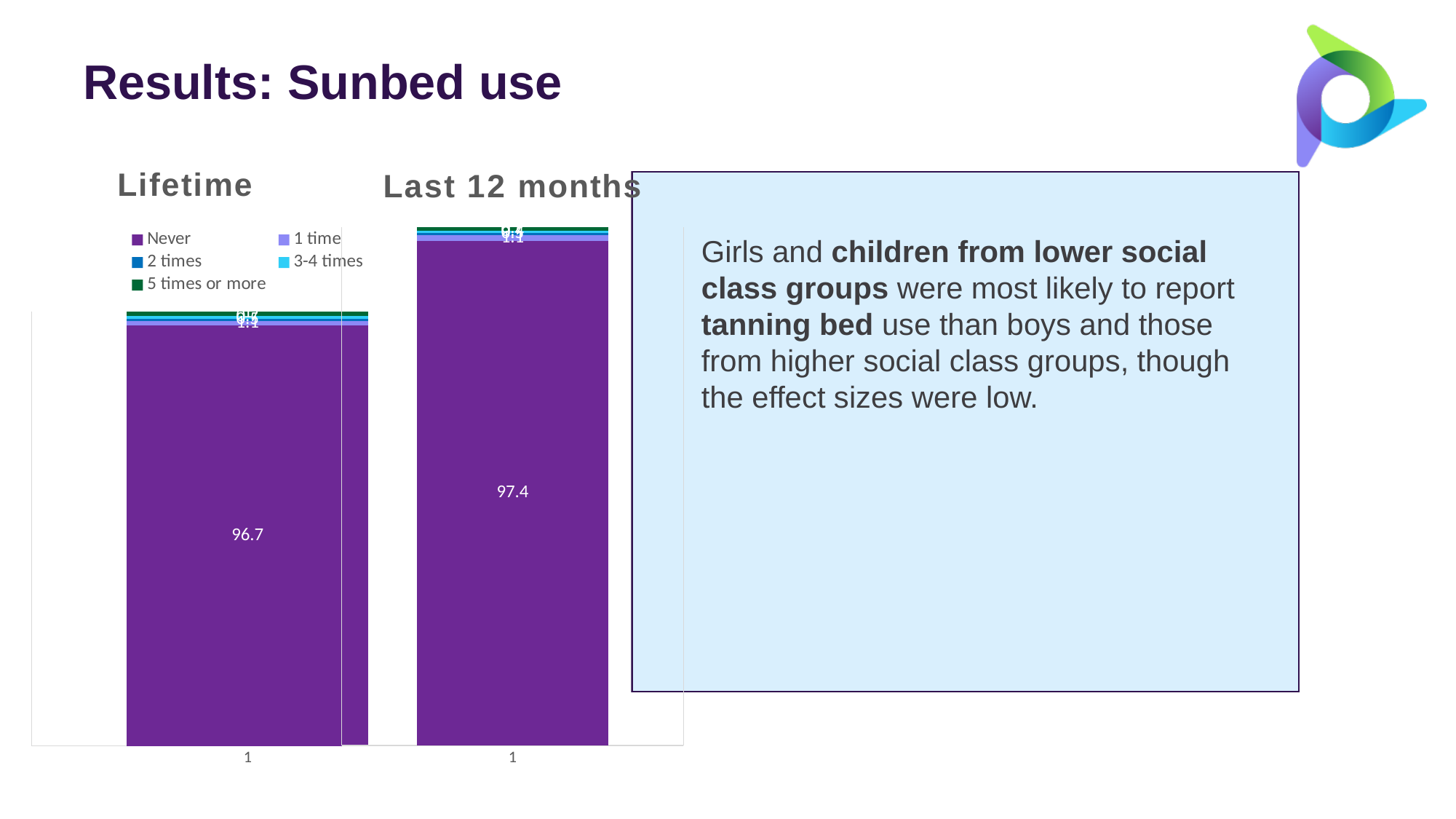
What are the legend entries of the Lifetime chart? Never, 1 time, 2 times, 3-4 times, 5 times or more In the Last 12 months chart, what is the value for the Never segment? 97.4 Which chart shows a larger value for Never, Lifetime or Last 12 months? Last 12 months In the Lifetime chart, what is the value for the Never segment? 96.7 In the Lifetime chart, which series makes up the largest segment of the bar? Never What kind of chart is the Lifetime chart? Stacked bar chart What is the difference between the Never value in the Last 12 months chart and the Never value in the Lifetime chart? 0.7 How many series does the legend of the Lifetime chart list? 5 In the Lifetime chart, what colour is the Never series? Purple How many bars does the Last 12 months chart contain? 1 In the Last 12 months chart, which series makes up the largest segment of the bar? Never